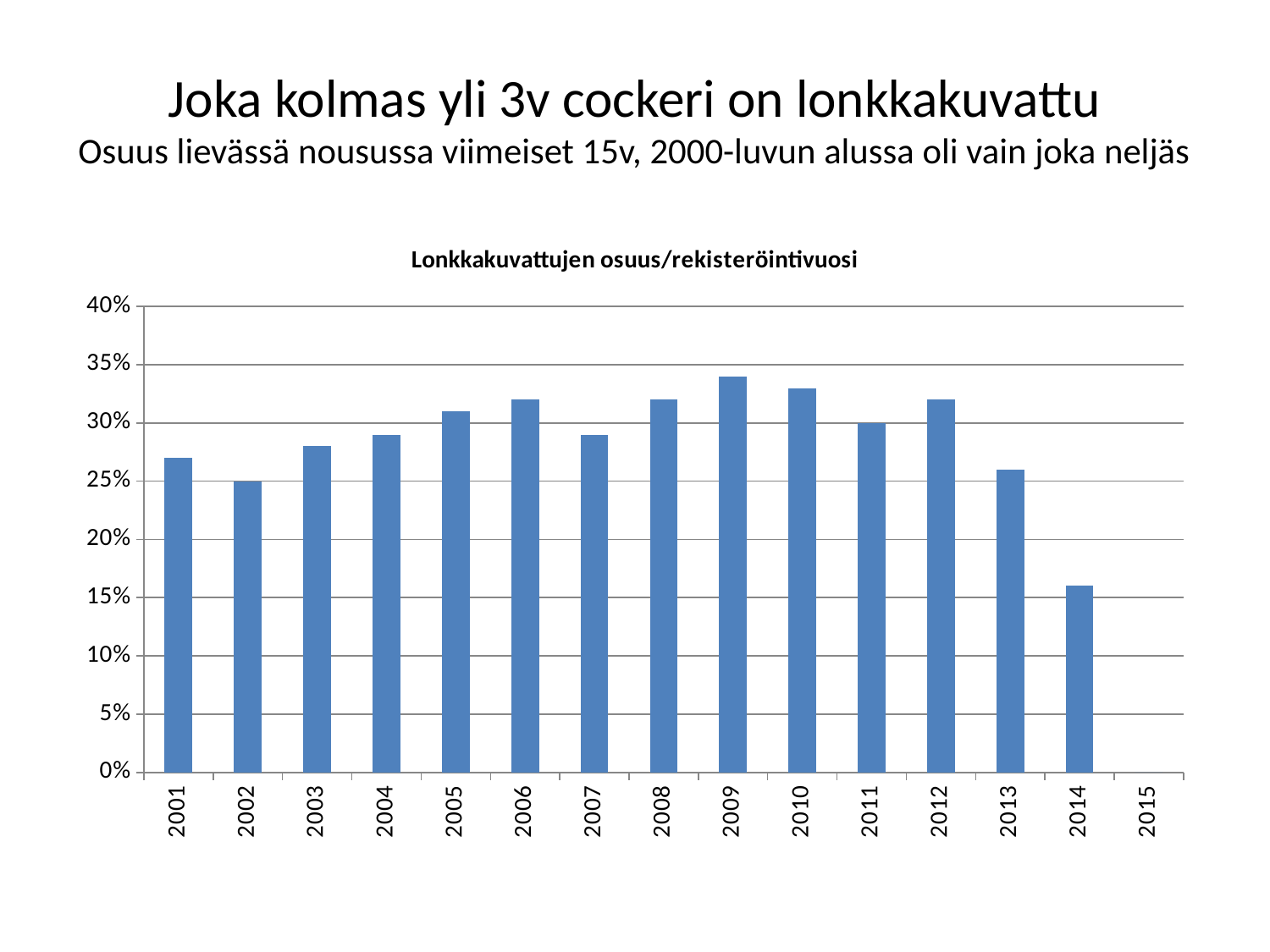
Is the value for 2005 greater or less than 30%? greater Which is larger, the value for 2006 or the value for 2002? 2006 Do the values rise or fall from 2012 to 2014? fall What is the value for 2011? 30% Which year has the highest value in the chart? 2009 How many years are labelled on the x axis? 15 What is the value for 2002? 25% Which year with a bar has the lowest value in the chart? 2014 Is the value for 2009 greater or less than 30%? greater What type of chart is shown on the slide? bar chart What is the title of the chart? Lonkkakuvattujen osuus/rekisteröintivuosi Is the value for 2014 greater or less than 20%? less